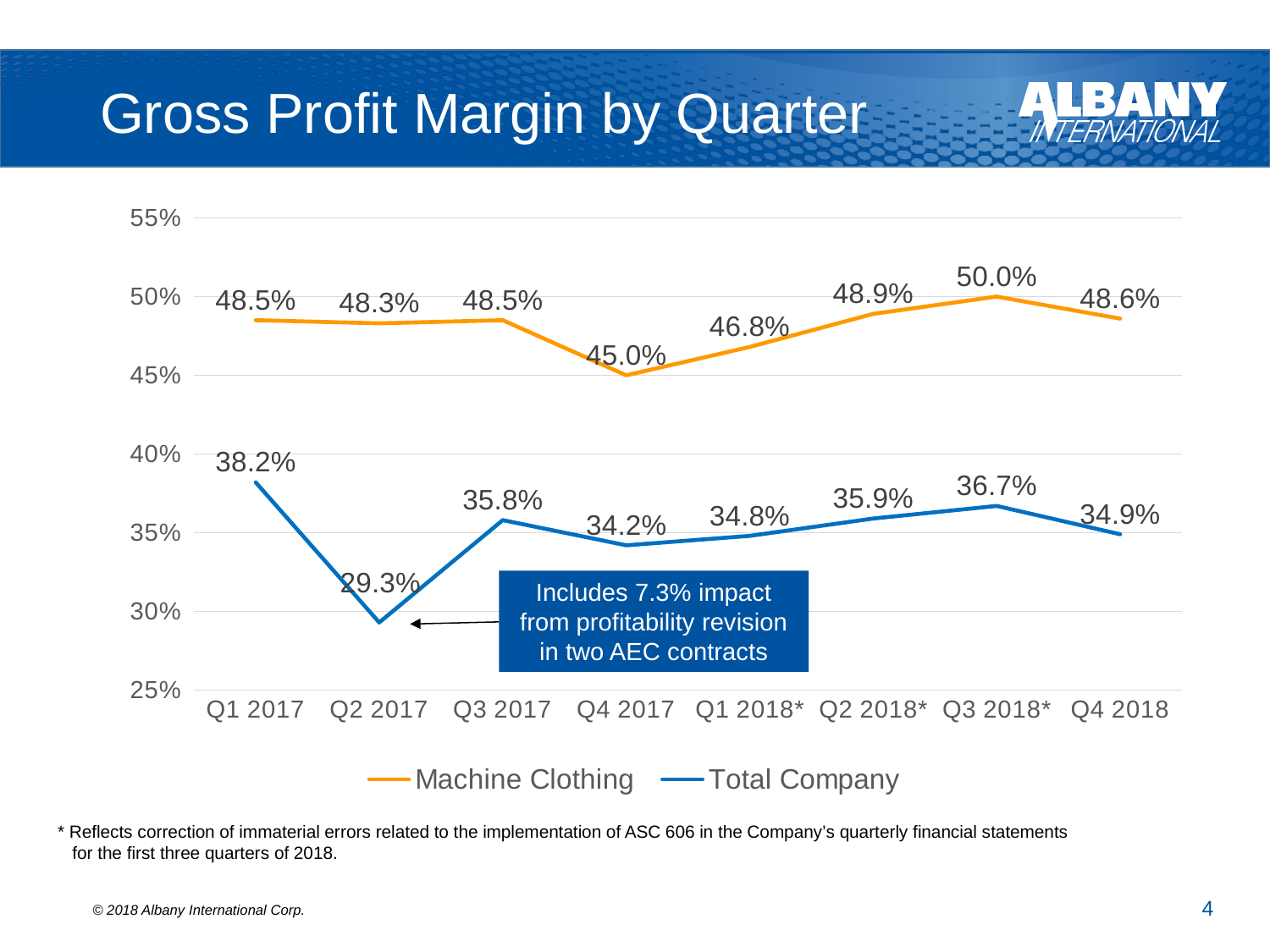
What is the difference between the Machine Clothing and Total Company margins in Q1 2018*? 12.0% What is the Total Company gross profit margin in Q2 2017? 29.3% How many quarters are shown on the x axis? 8 In which quarter is the Total Company margin highest? Q1 2017 What is the Total Company gross profit margin in Q4 2018? 34.9% How many series does the legend list? 2 Is the Total Company margin in Q2 2017 greater or less than 30%? less Does the Machine Clothing margin rise or fall from Q3 2018* to Q4 2018? fall What kind of chart is shown on the slide? line chart In which quarter is the Machine Clothing margin lowest? Q4 2017 What is the Machine Clothing gross profit margin in Q3 2018*? 50.0% Which is larger, the Total Company margin in Q3 2017 or in Q4 2017? Q3 2017